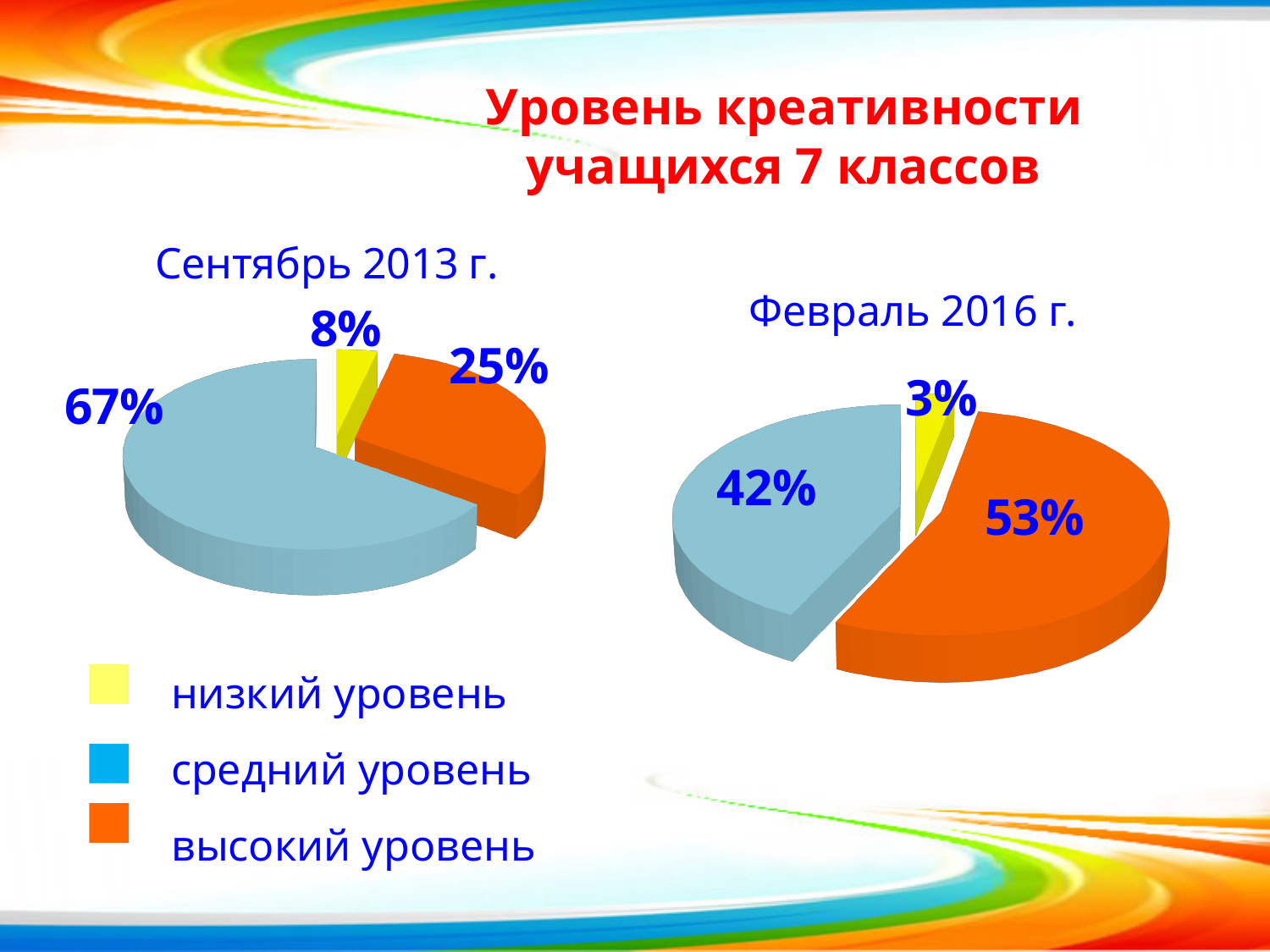
In the 'Сентябрь 2013 г.' chart, which level has the largest slice? средний уровень What is the difference between the medium level share in the 'Сентябрь 2013 г.' chart and the medium level share in the 'Февраль 2016 г.' chart? 25% In the 'Февраль 2016 г.' chart, what share is labelled for the medium level (средний уровень) slice? 42% In the 'Февраль 2016 г.' chart, which is larger: the high level slice or the medium level slice? высокий уровень Which level does the orange colour represent in the legend? высокий уровень How many slices does the 'Сентябрь 2013 г.' chart have? 3 What type of chart is used for 'Февраль 2016 г.'? Pie chart What is the difference between the high level share in the 'Февраль 2016 г.' chart and the high level share in the 'Сентябрь 2013 г.' chart? 28% In the 'Сентябрь 2013 г.' chart, what share is labelled for the high level (высокий уровень) slice? 25% In the 'Февраль 2016 г.' chart, what share is labelled for the high level (высокий уровень) slice? 53% In the 'Февраль 2016 г.' chart, which level has the smallest slice? низкий уровень In the 'Сентябрь 2013 г.' chart, what share is labelled for the low level (низкий уровень) slice? 8%